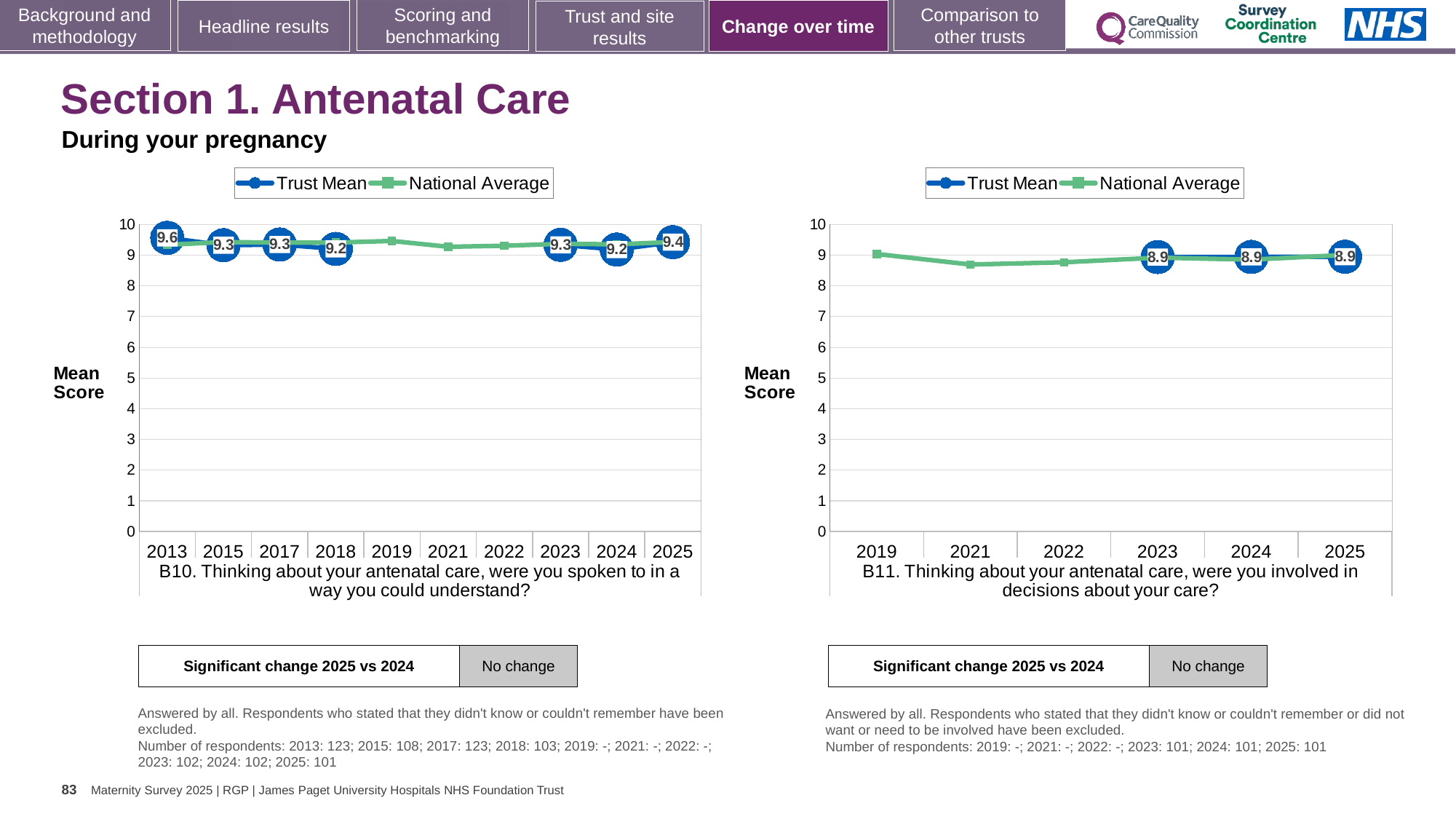
In the B10 chart on the left, is the Trust Mean for 2013 larger or smaller than the Trust Mean for 2018? larger How many years are shown on the x axis of the B11 chart on the right? 6 How many series does the legend of the B11 chart on the right list? 2 In the B11 chart on the right, what is the Trust Mean for 2024? 8.9 In the B10 chart on the left, what is the Trust Mean for 2013? 9.6 In the B10 chart on the left, what is the Trust Mean for 2025? 9.4 In the B10 chart on the left, what is the difference between the Trust Mean for 2013 and the Trust Mean for 2024? 0.4 What kind of chart is the B10 chart on the left? Line chart In the B10 chart on the left, which year has the highest labelled Trust Mean? 2013 In the B11 chart on the right, is the National Average for 2021 greater or less than 9? less How many years are shown on the x axis of the B10 chart on the left? 10 What are the two series named in the legend of the B10 chart on the left? Trust Mean and National Average